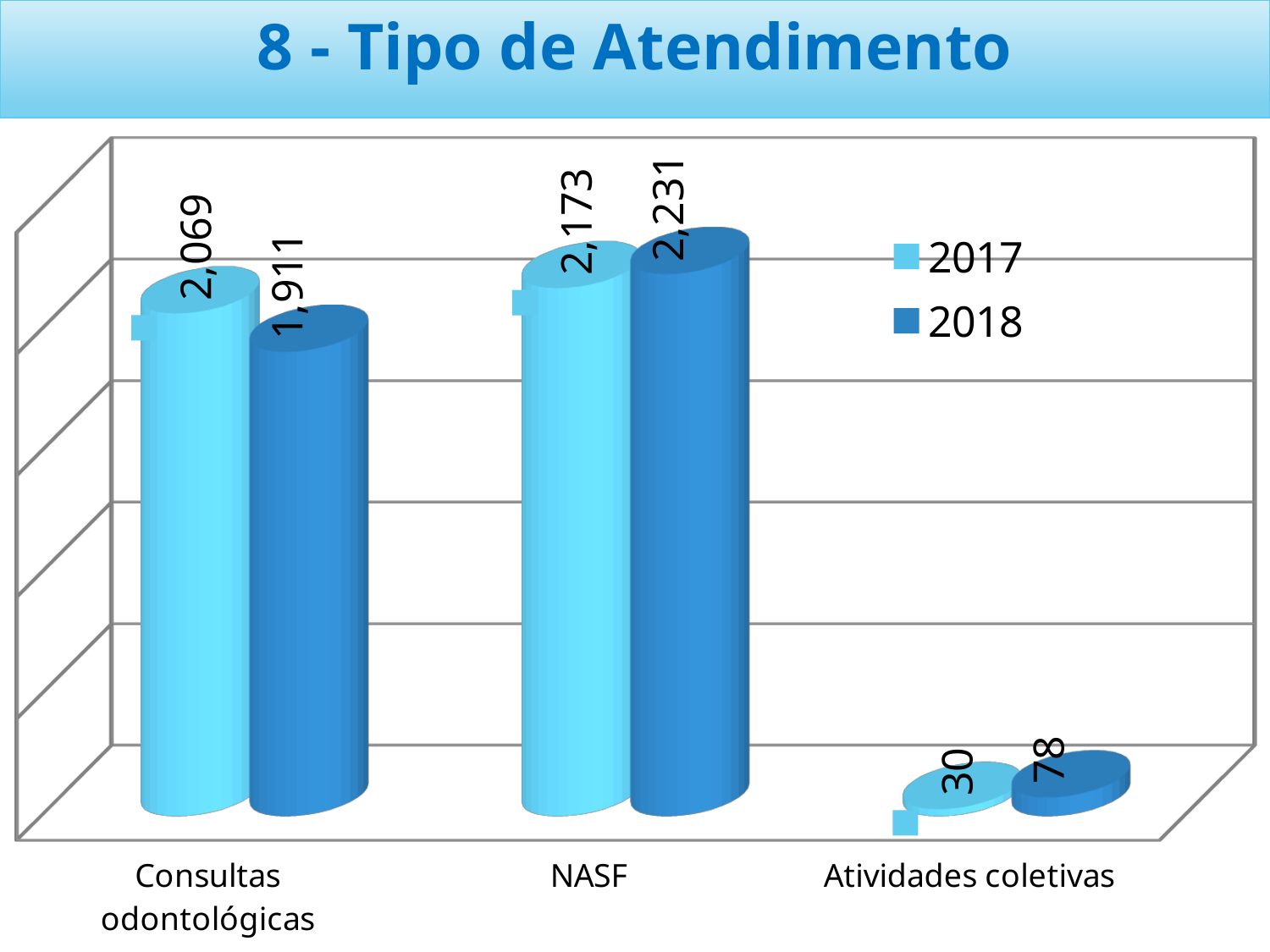
What is the difference between the 2018 and 2017 values for Atividades coletivas? 48 What is the value for Consultas odontológicas in 2017? 2,069 What is the value for Consultas odontológicas in 2018? 1,911 What is the value for NASF in 2018? 2,231 How many categories are shown on the x axis? 3 What is the value for Atividades coletivas in 2017? 30 How many series does the legend list? 2 Which category has the highest value in 2018? NASF Which category has the lowest value in 2017? Atividades coletivas Which is larger for NASF, the 2017 value or the 2018 value? 2018 What is the difference between the 2017 and 2018 values for Consultas odontológicas? 158 What kind of chart is shown on the slide? Bar chart